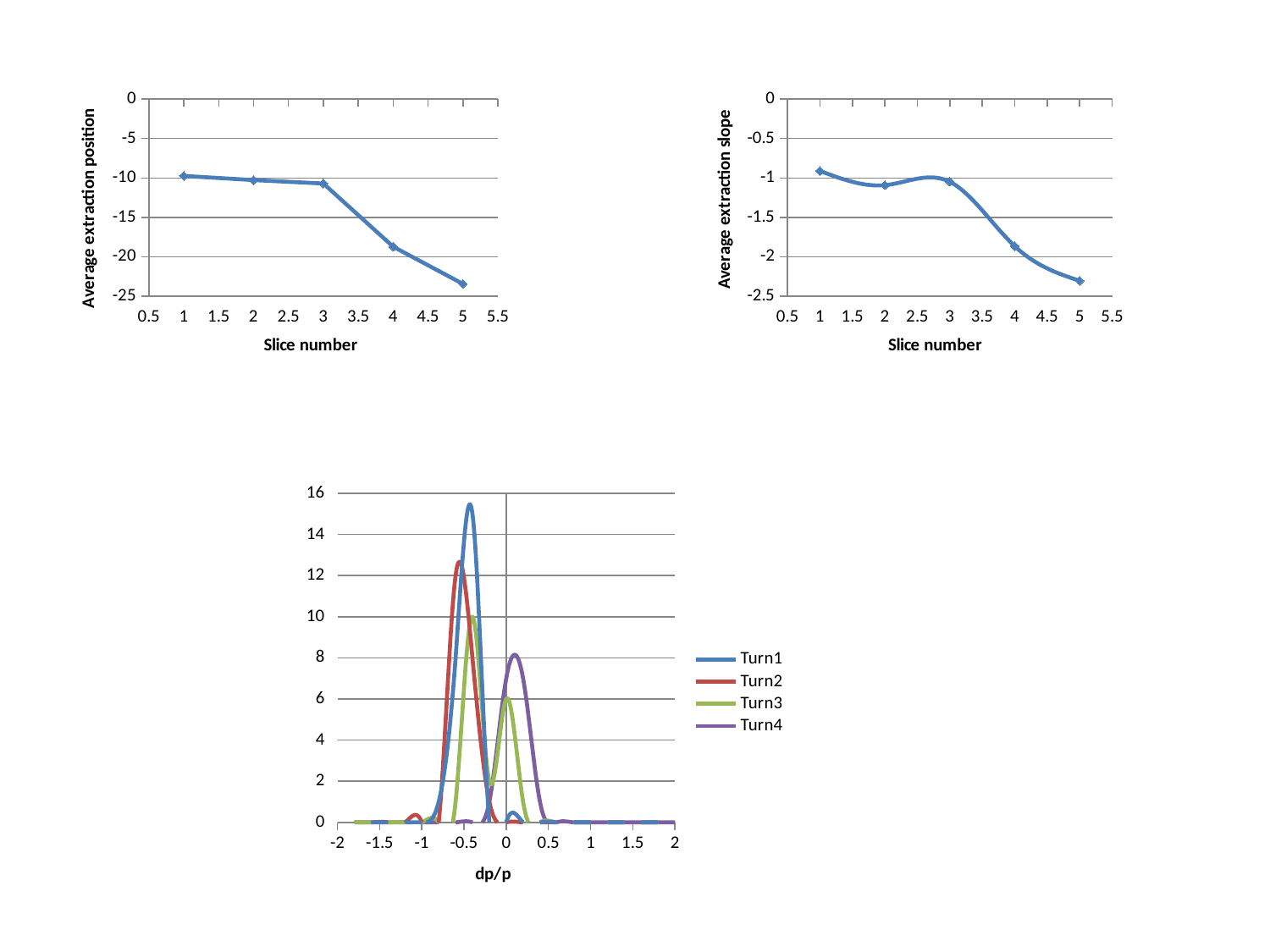
In the top-right chart (Average extraction slope), which is larger, the value for slice 3 or the value for slice 5? slice 3 In the bottom chart (dp/p), is the peak value of Turn3 greater or less than 8? greater What kind of chart is the top-left chart (Average extraction position vs Slice number)? line chart In the top-right chart (Average extraction slope), is the value for slice 4 greater or less than -1.5? less In the bottom chart (dp/p), is the peak value of Turn4 greater or less than 6? greater In the top-left chart (Average extraction position), do the values rise or fall as the slice number increases? fall How many data points are plotted in the top-left chart (Average extraction position)? 5 In the bottom chart (dp/p), which series reaches the highest peak? Turn1 How many series does the legend of the bottom chart (dp/p) list? 4 In the top-left chart (Average extraction position), which slice number has the lowest value? 5 What is the x-axis label of the top-right chart (Average extraction slope)? Slice number